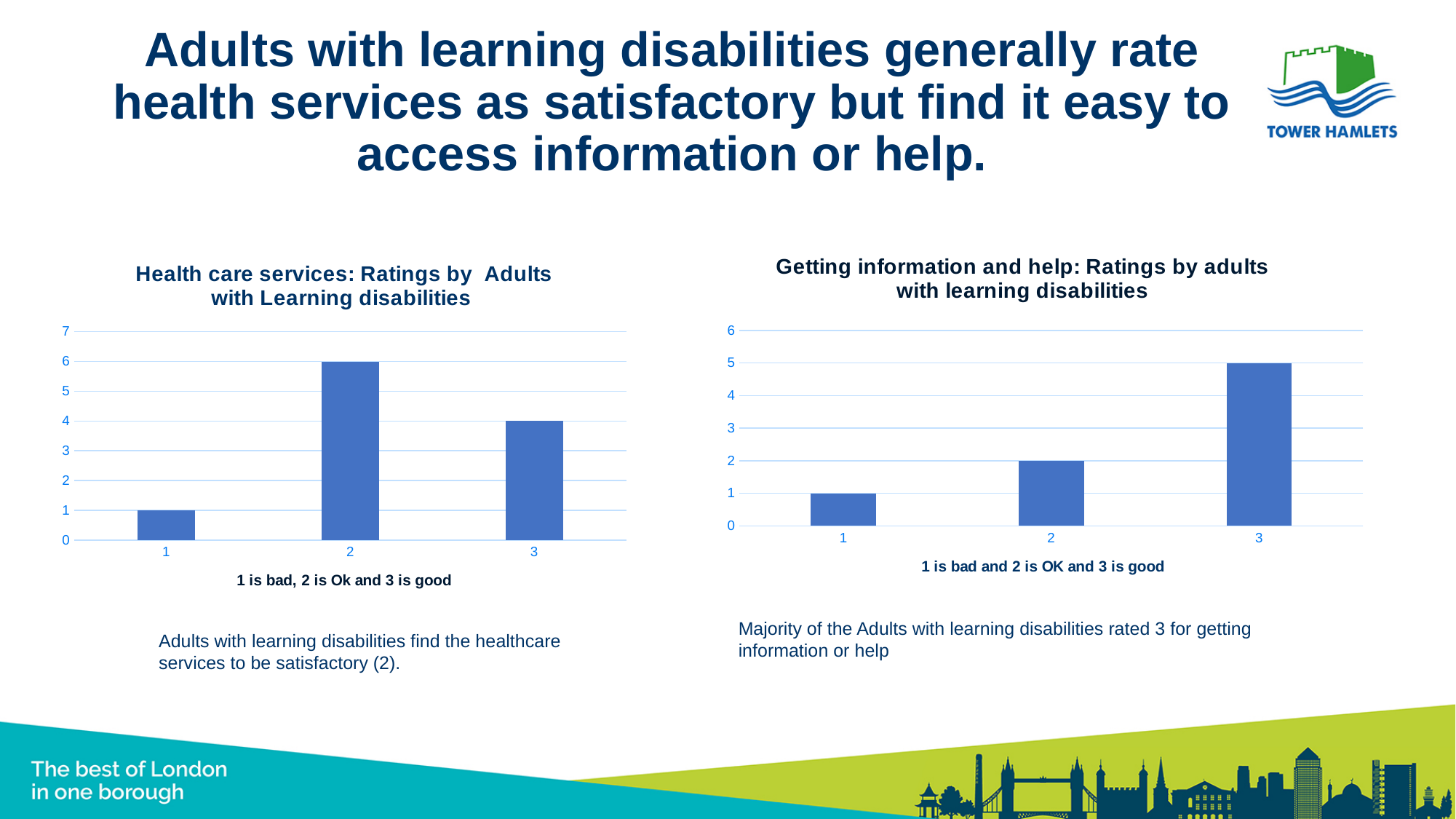
In the 'Getting information and help' chart, what is the value for rating 3? 5 In the 'Health care services' chart, what is the value for rating 2? 6 In the 'Getting information and help' chart, which rating has the highest value? 3 In the 'Health care services' chart, which rating has the highest value? 2 In the 'Health care services' chart, which rating has the lowest value? 1 In the 'Health care services' chart, what is the value for rating 3? 4 In the 'Health care services' chart, what is the difference between the values for rating 2 and rating 3? 2 What type of chart is the 'Getting information and help' chart? bar chart In the 'Getting information and help' chart, do the values rise or fall from rating 1 to rating 3? rise In the 'Getting information and help' chart, what is the value for rating 1? 1 How many rating categories are shown in the 'Health care services' chart? 3 In the 'Getting information and help' chart, which is larger, the value for rating 2 or rating 3? 3